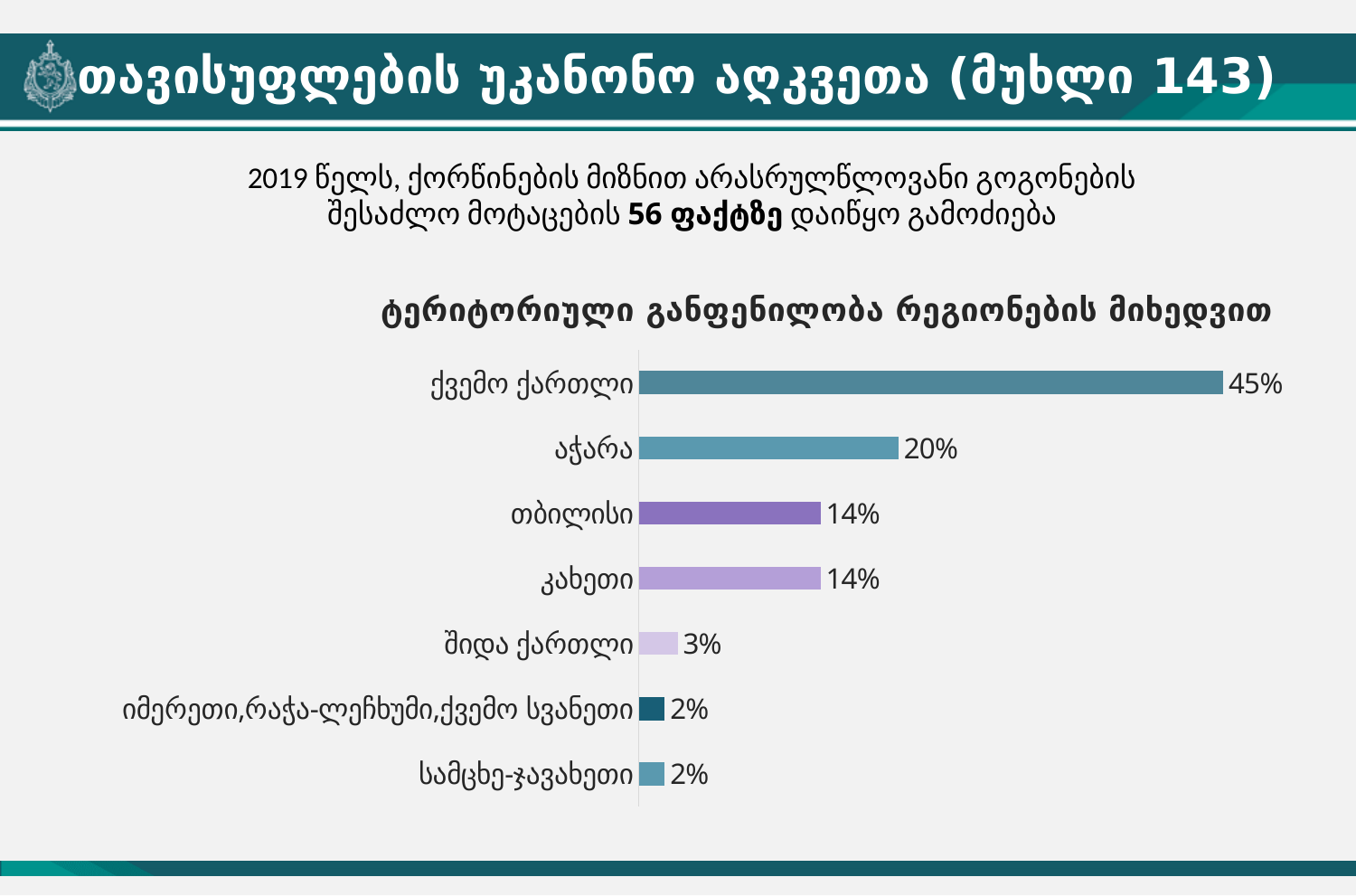
Which is larger, the value for აჭარა or the value for თბილისი? აჭარა What is the value for სამცხე-ჯავახეთი? 2% What is the title of the chart? ტერიტორიული განფენილობა რეგიონების მიხედვით What kind of chart is shown on the slide? Bar chart Which region has the highest value? ქვემო ქართლი What is the value for ქვემო ქართლი? 45% What is the difference between the values for კახეთი and შიდა ქართლი? 11% What is the difference between the values for ქვემო ქართლი and აჭარა? 25% What is the value for შიდა ქართლი? 3% How many regions are shown in the chart? 7 What is the value for აჭარა? 20% What is the value for თბილისი? 14%